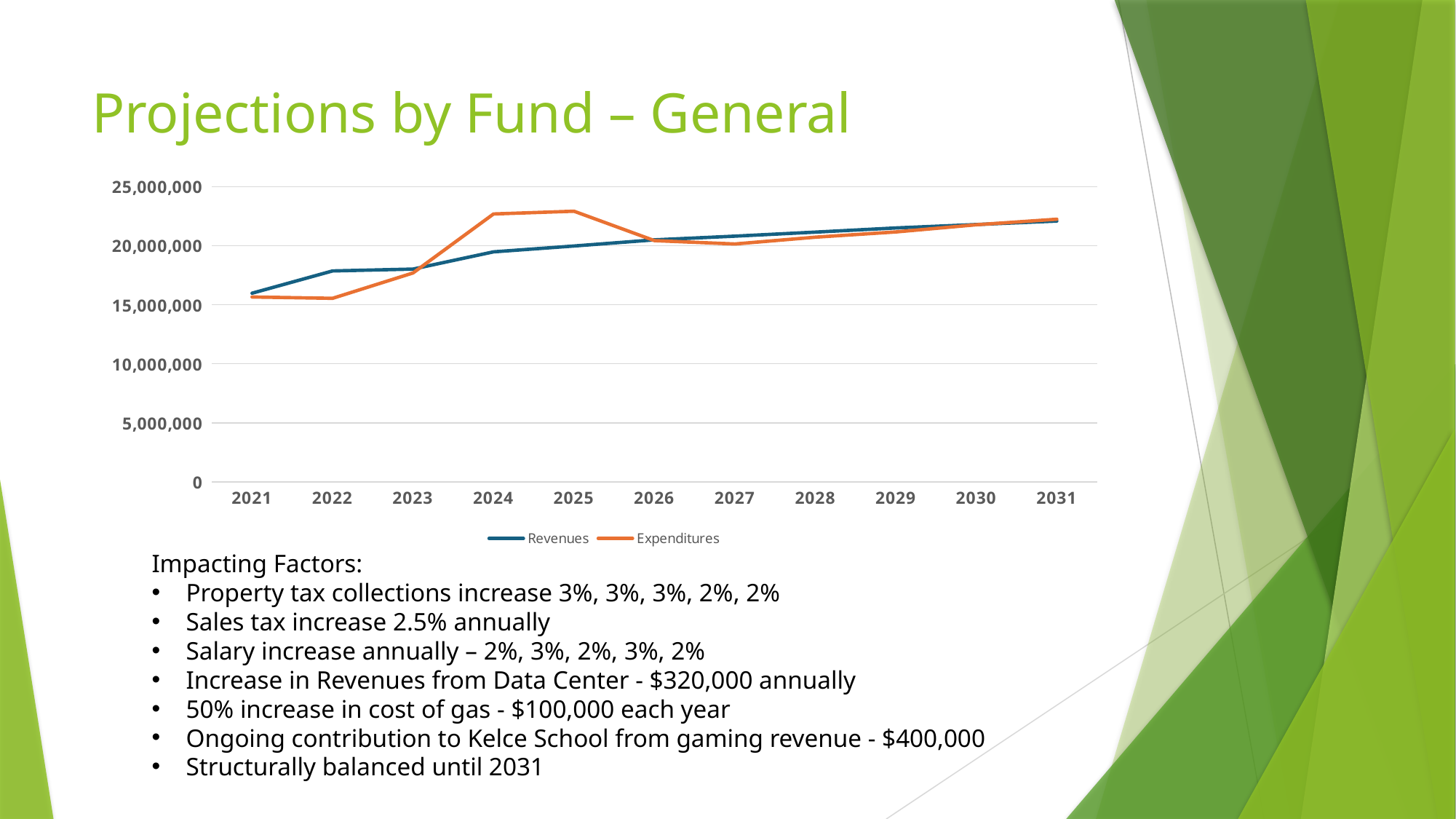
How many years are shown on the x axis? 11 What kind of chart is shown on the slide? Line chart How many series does the legend list? 2 Is the value for Revenues in 2031 greater or less than 20,000,000? greater Do Revenues generally rise or fall from 2021 to 2031? Rise Is the value for Revenues in 2021 greater or less than 15,000,000? greater Is the value for Revenues in 2023 greater or less than 20,000,000? less Which series is drawn in orange? Expenditures In 2022, which is larger, Revenues or Expenditures? Revenues Which year has the lowest Revenues value? 2021 In 2025, which is larger, Revenues or Expenditures? Expenditures